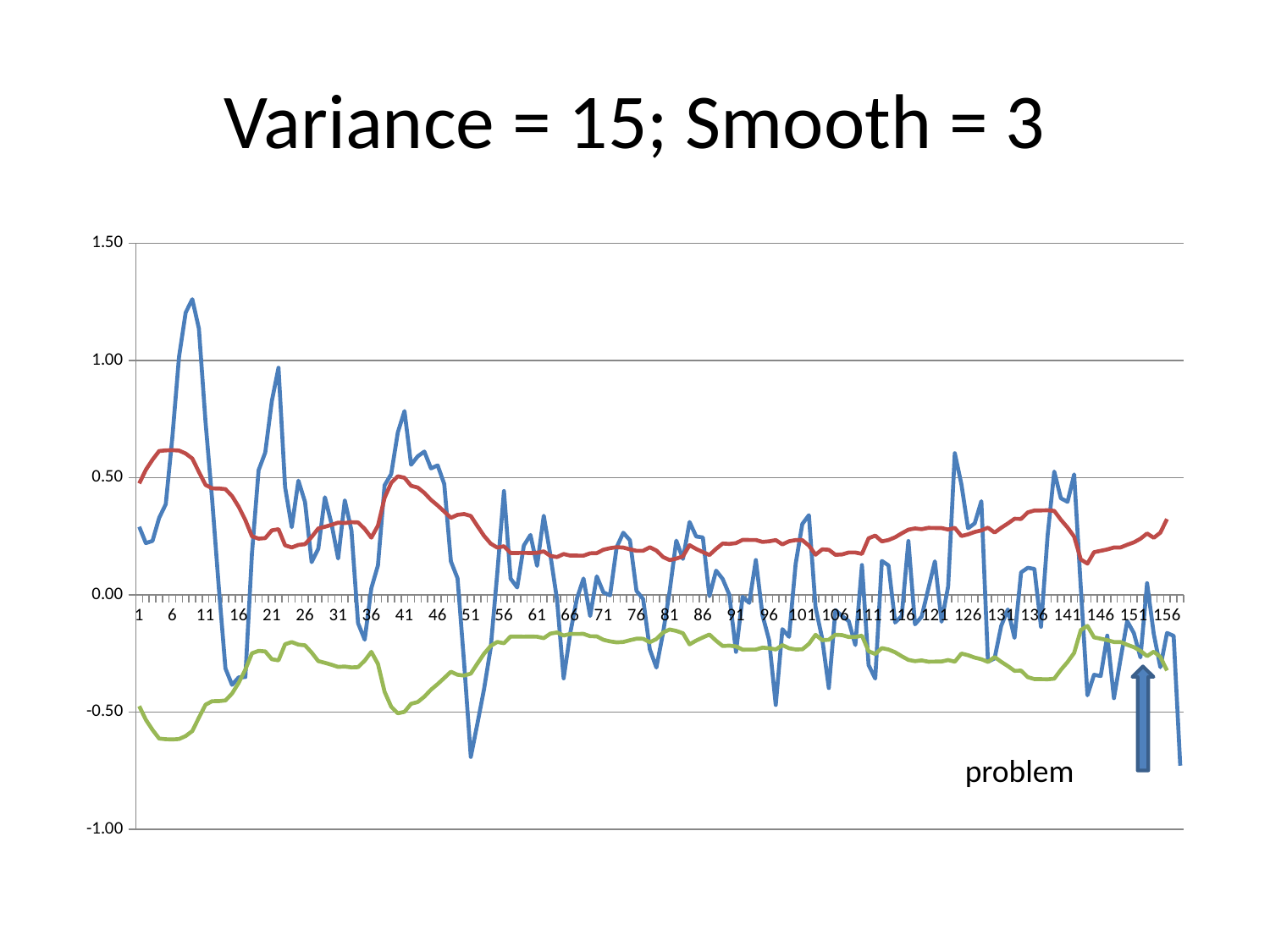
Is the value of the blue line at x = 51 greater or less than -0.50? less How many lines are plotted on the chart? 3 What kind of chart is shown on the slide? line chart Is the peak value of the blue line near x = 9 greater or less than 1.00? greater Which of the three lines reaches the highest value anywhere on the chart? blue line What is the highest value labelled on the vertical axis? 1.50 At x = 6, which line has the higher value, the red line or the green line? red line Is the value of the green line at x = 6 greater or less than -0.50? less What is the title of the chart on the slide? Variance = 15; Smooth = 3 What is the last category label shown on the horizontal axis? 156 Does the red line rise or fall between x = 1 and x = 16? fall